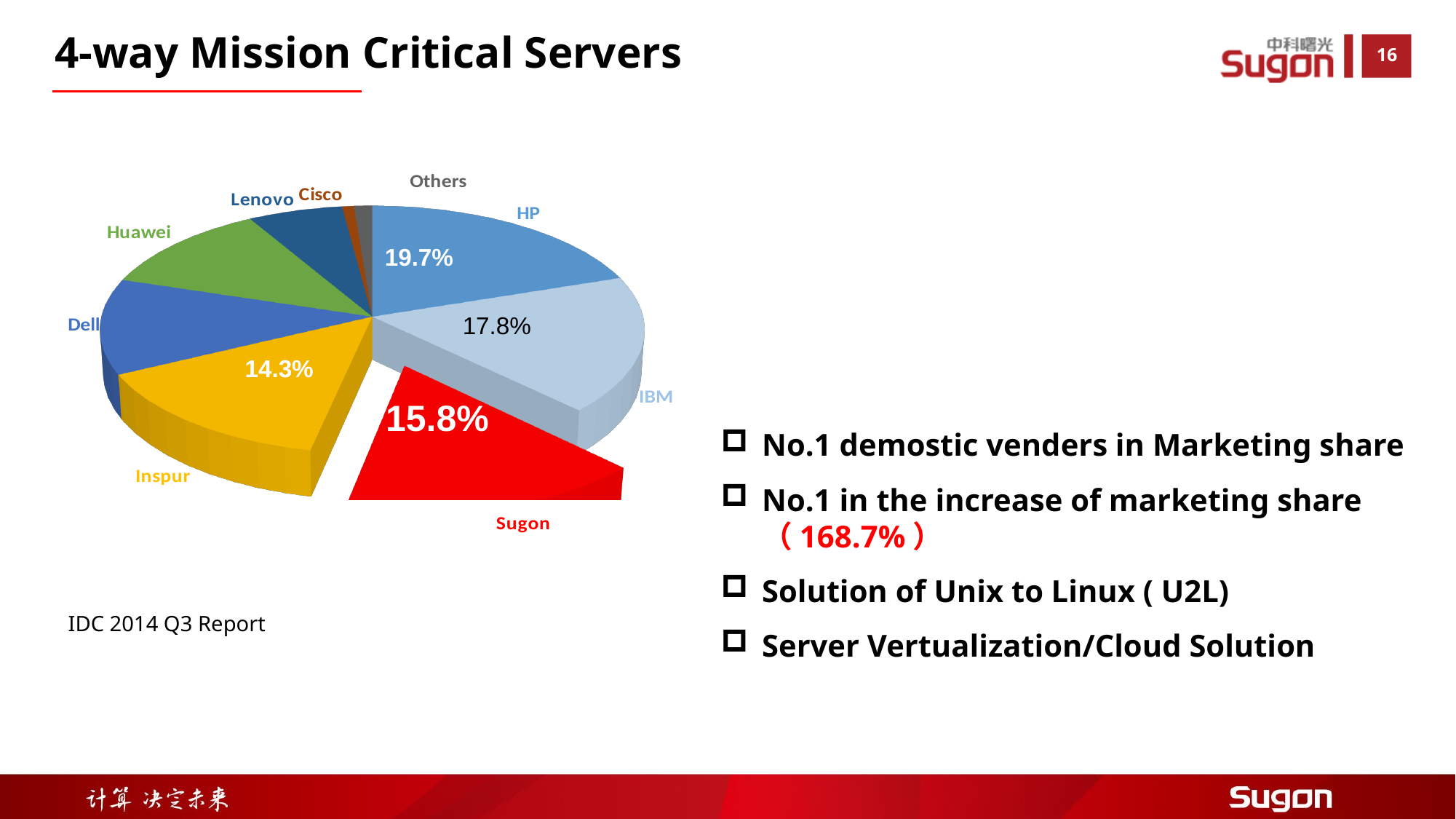
What is the value shown for Inspur? 14.3% Which is larger, the share for Sugon or the share for Inspur? Sugon Which vendor has the largest slice of the pie? HP How much larger is Sugon's share than Inspur's share? 1.5% Which slice is pulled out (exploded) from the rest of the pie? Sugon What is the value shown for IBM? 17.8% What share of the pie does HP hold? 19.7% Which is larger, the slice for Huawei or the slice for Cisco? Huawei What is the difference between HP's share and IBM's share? 1.9% How many vendor categories (slices) are shown in the pie chart? 9 What percentage is labelled on the Sugon slice? 15.8% What type of chart is shown on the slide? Pie chart